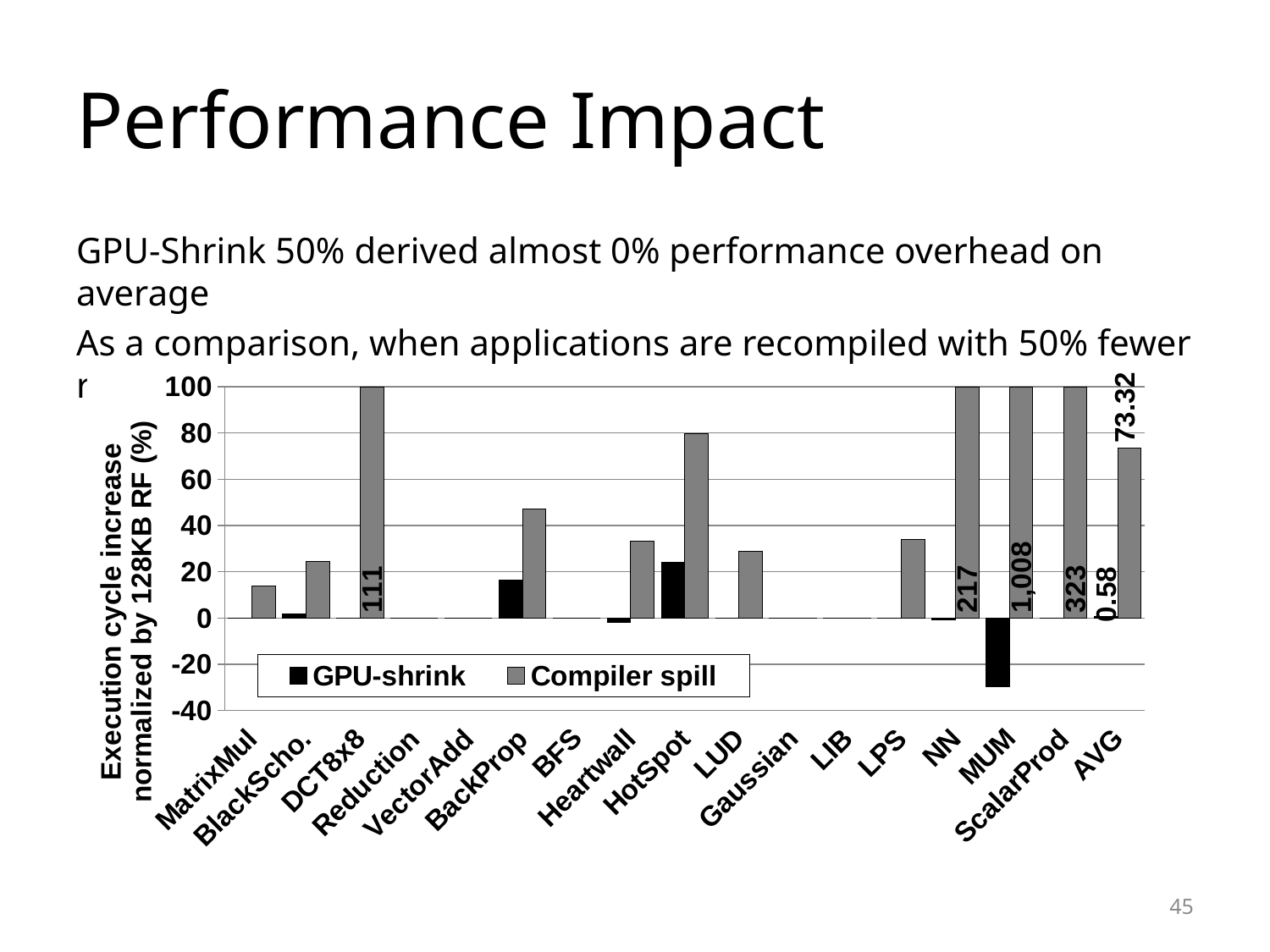
What is the difference between the Compiler spill values for MUM and ScalarProd? 685 Is the GPU-shrink value for MUM greater or less than -20? less How many categories are shown on the x axis? 17 How many series does the legend list? 2 What is the Compiler spill value for ScalarProd? 323 Which category has the highest Compiler spill value? MUM What is the GPU-shrink value for AVG? 0.58 What is the Compiler spill value for NN? 217 Which category has the lowest GPU-shrink value? MUM Is the Compiler spill value for HotSpot greater or less than 60? greater What is the Compiler spill value for MUM? 1,008 What is the Compiler spill value for AVG? 73.32